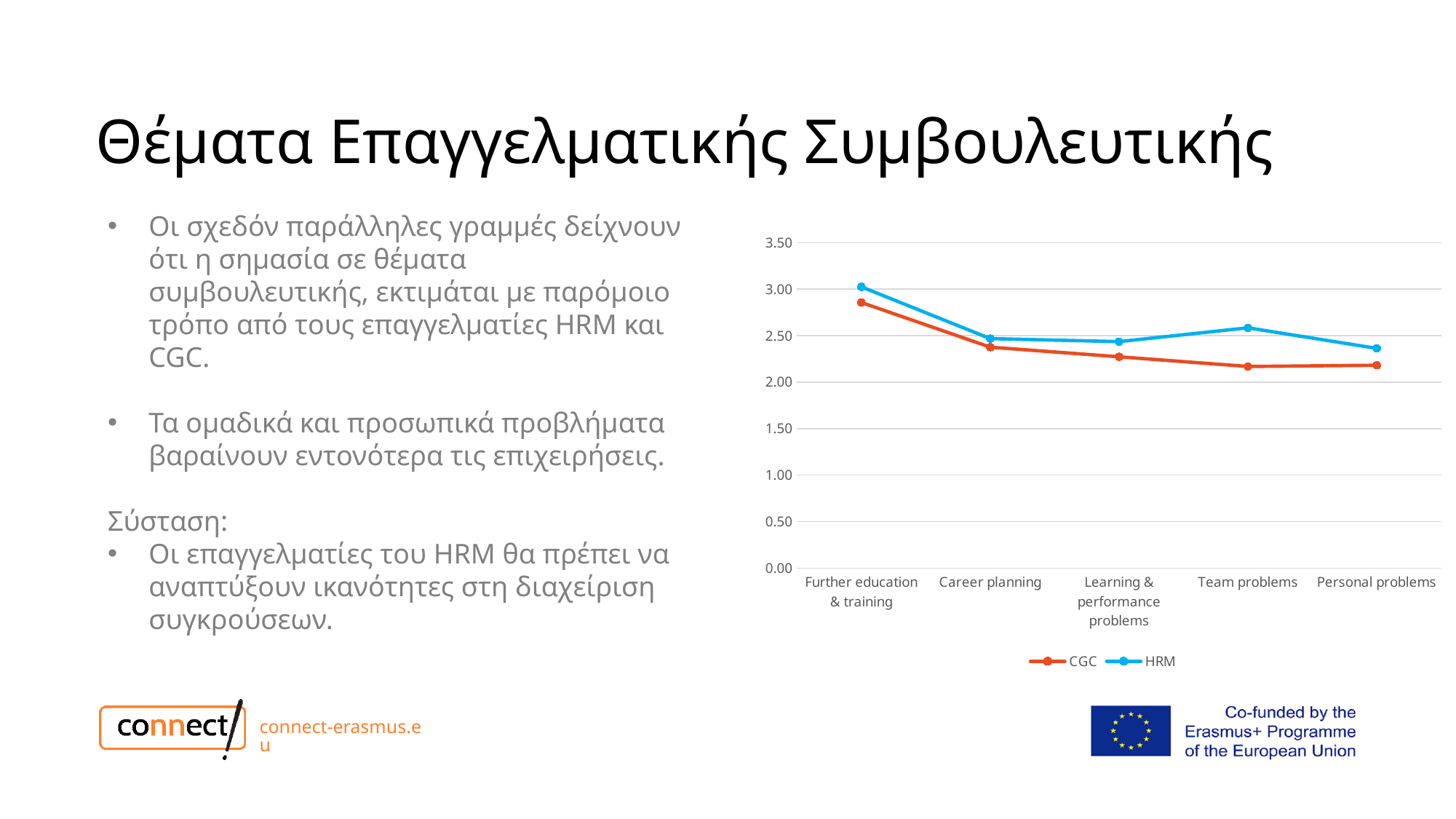
Is the CGC value for Further education & training greater or less than 2.50? greater How many series does the chart legend list? 2 Which series has the larger value for Team problems, CGC or HRM? HRM How many categories are shown on the x axis of the chart? 5 Is the CGC value for Team problems greater or less than 2.50? less Does the CGC line generally rise or fall from Further education & training to Personal problems? fall Is the HRM value for Personal problems greater or less than 2.00? greater For which category is the HRM value highest? Further education & training For which category is the CGC value highest? Further education & training What kind of chart is shown on the slide? line chart Which colour is used for the HRM series in the chart? blue Which series has the larger value for Further education & training, CGC or HRM? HRM